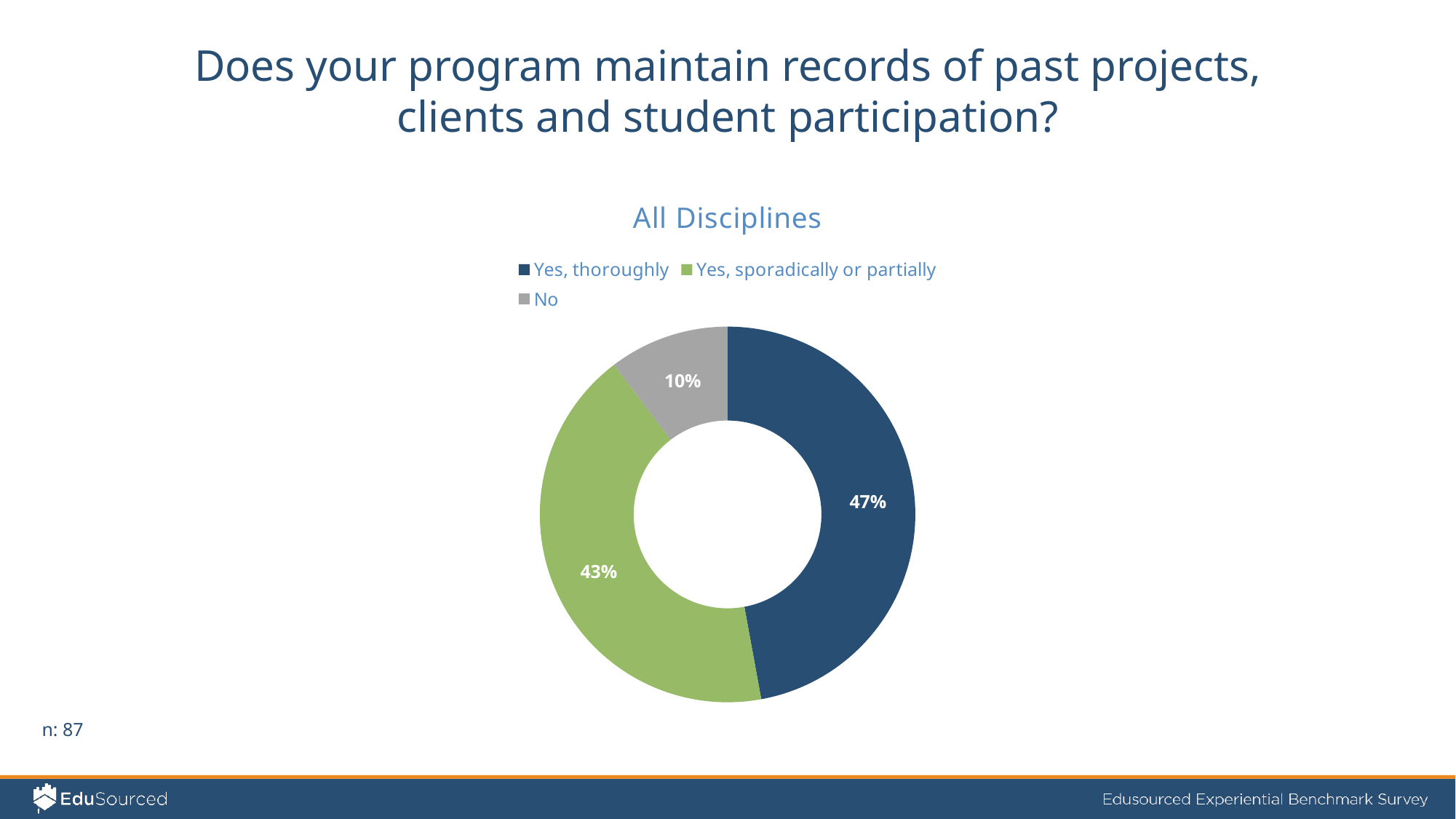
What share of respondents answered "Yes, thoroughly"? 47% What share of respondents answered "Yes, sporadically or partially"? 43% How many response categories does the chart show? 3 What kind of chart is shown on the slide? Pie chart (doughnut) What is the difference in percentage points between "Yes, thoroughly" and "Yes, sporadically or partially"? 4 percentage points What is the title of the chart? All Disciplines What is the difference in percentage points between "Yes, sporadically or partially" and "No"? 33 percentage points Which response has the smallest share of the chart? No What is the sample size (n) shown on the slide? 87 Which response has the largest share of the chart? Yes, thoroughly What share of respondents answered "No"? 10% Which is larger: the share for "Yes, thoroughly" or the share for "No"? Yes, thoroughly